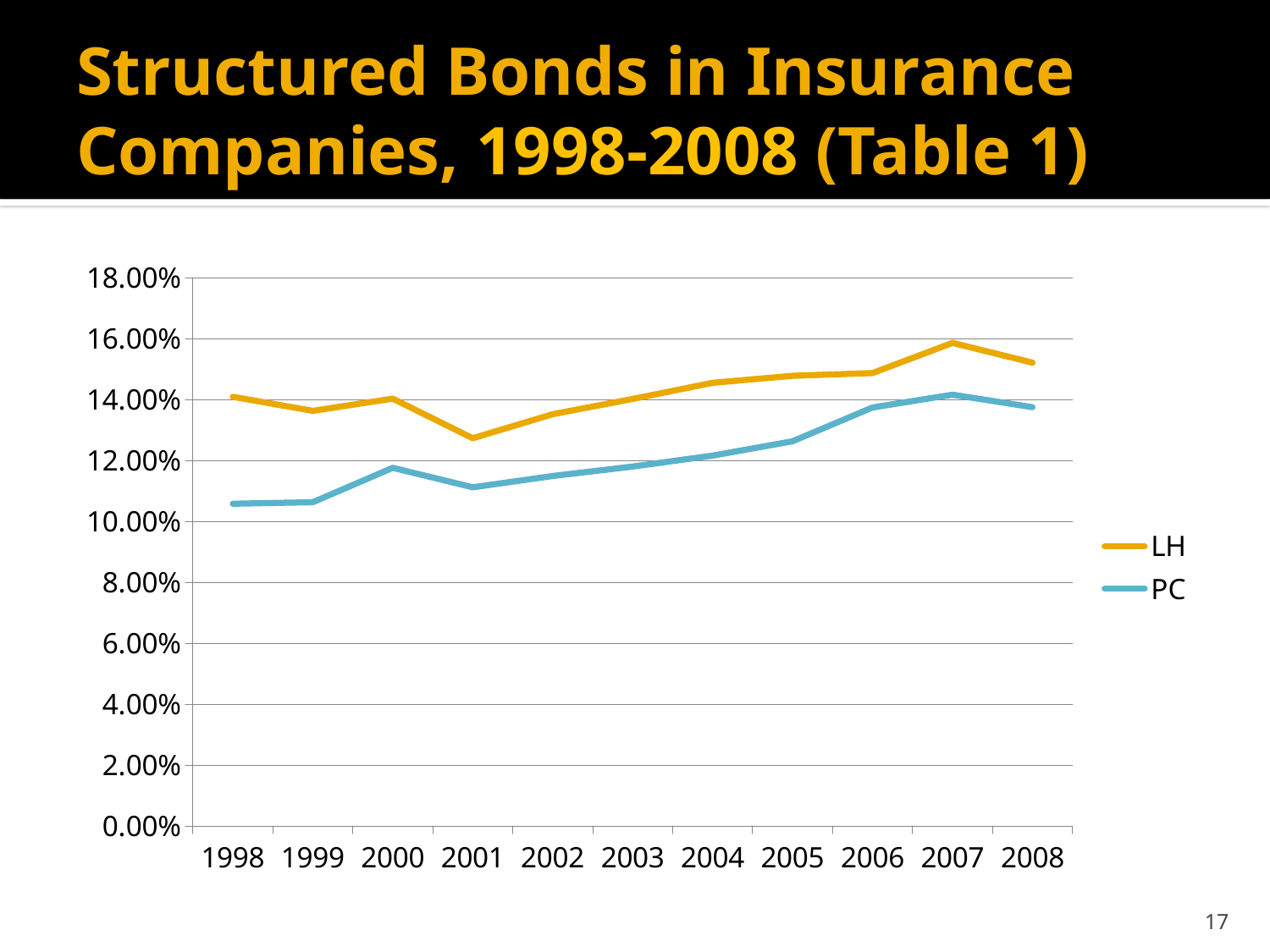
How many years are plotted along the x axis? 11 Is the value for LH in 2007 greater or less than 14.00%? greater Does the PC series generally rise or fall from 1998 to 2008? rise What kind of chart is shown on the slide? line chart In which year does the PC series reach its highest value? 2007 Which series has the larger value in 2008, LH or PC? LH Is the value for PC in 1998 greater or less than 12.00%? less Is the value for LH in 2001 greater or less than 12.00%? greater How many series does the legend list? 2 In which year does the LH series reach its highest value? 2007 In which year does the LH series reach its lowest value? 2001 What colour is the line for the PC series? blue